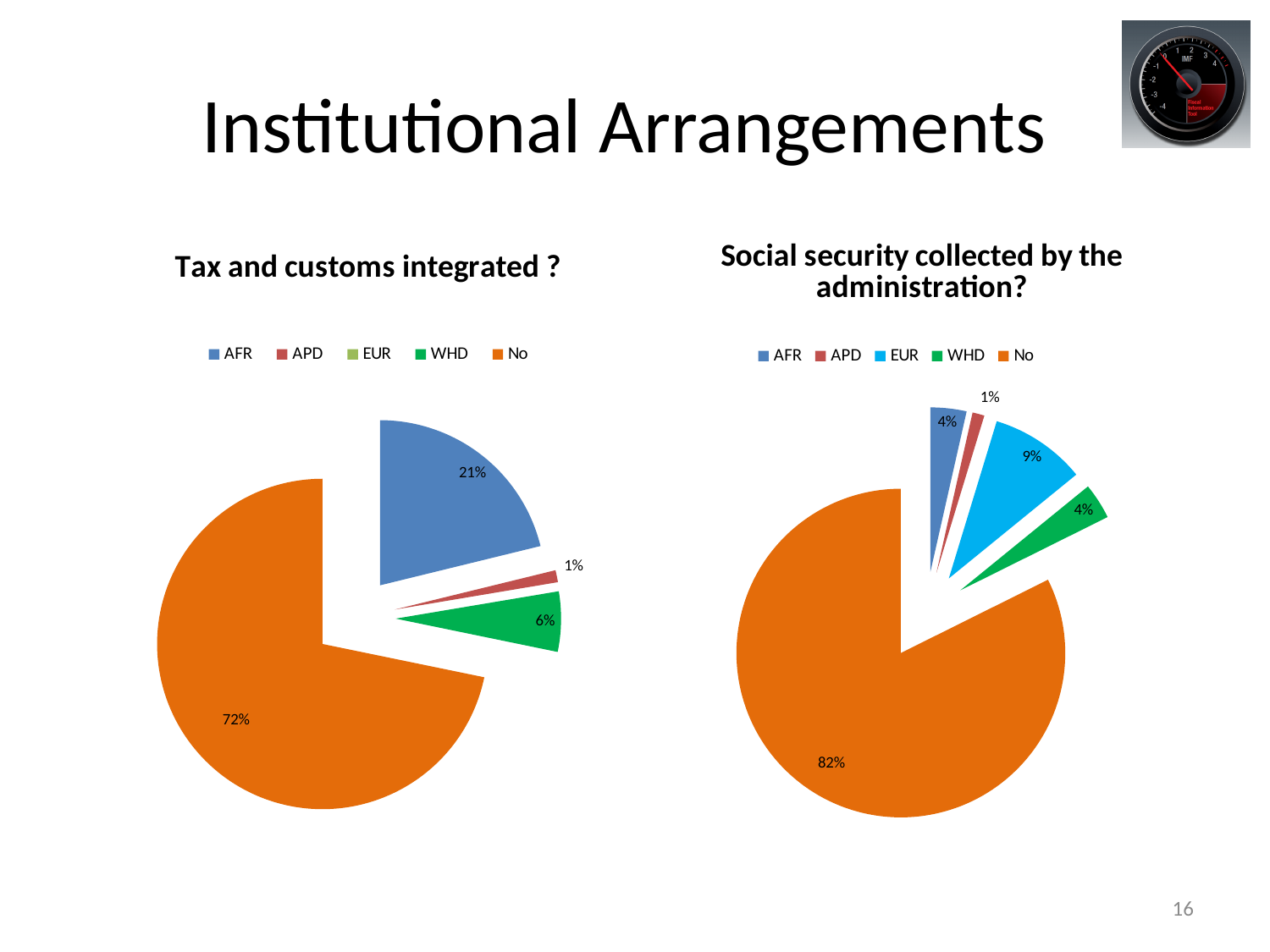
In the 'Social security collected by the administration?' chart, which is larger, the EUR slice or the WHD slice? EUR In the 'Social security collected by the administration?' chart, what share is labelled for the No slice? 82% In the 'Social security collected by the administration?' chart, what share is labelled for EUR? 9% In the 'Tax and customs integrated ?' chart, what share is labelled for the No slice? 72% How many entries does the legend of the 'Social security collected by the administration?' chart list? 5 In the 'Tax and customs integrated ?' chart, what is the difference between the No share and the AFR share? 51% In the 'Tax and customs integrated ?' chart, which category has the largest slice? No In the 'Tax and customs integrated ?' chart, what share is labelled for WHD? 6% In the 'Tax and customs integrated ?' chart, what share is labelled for AFR? 21% In the 'Social security collected by the administration?' chart, which category has the smallest labelled slice? APD In the 'Social security collected by the administration?' chart, what share is labelled for APD? 1% What type of chart is used for 'Tax and customs integrated ?'? Pie chart